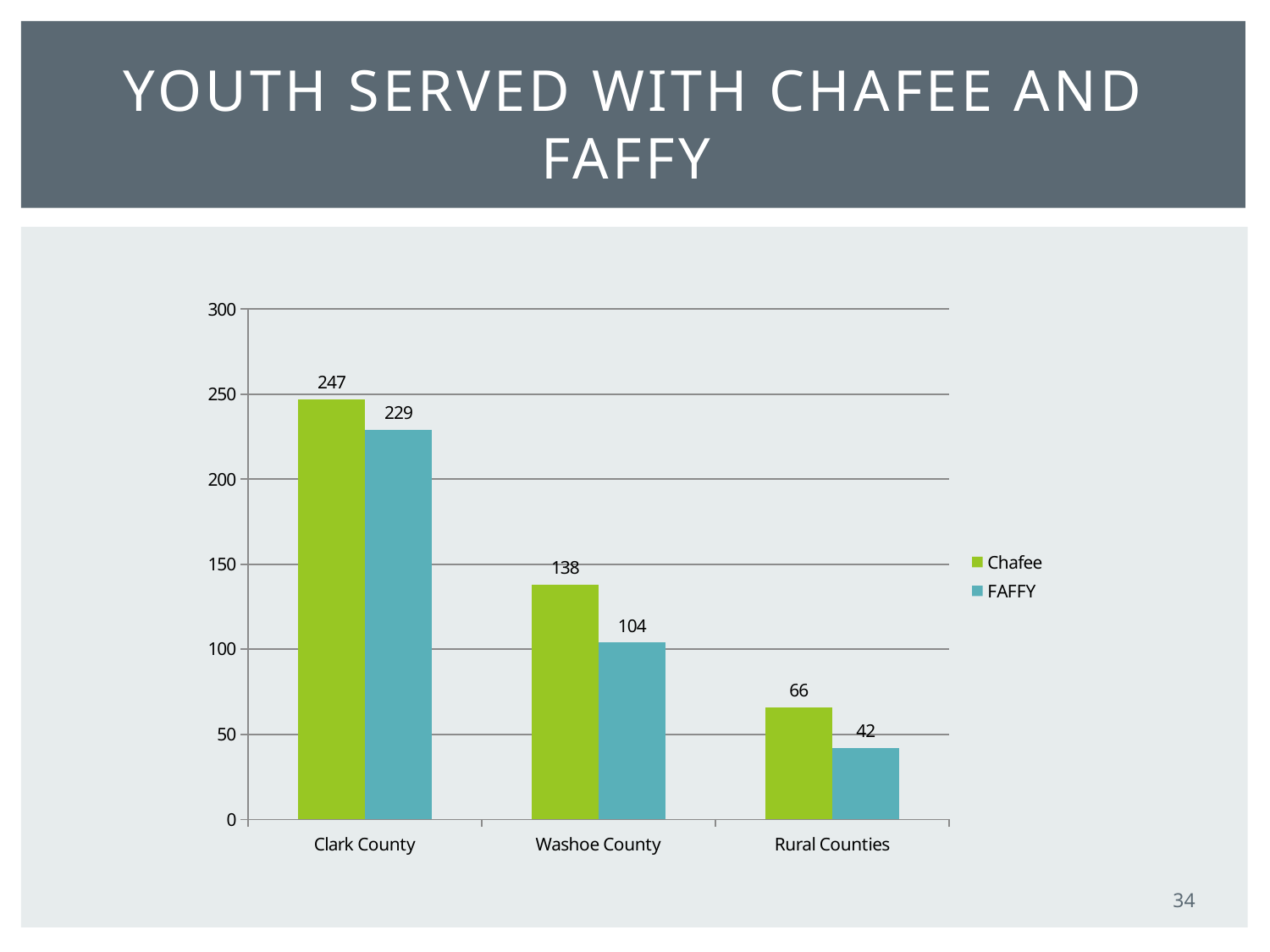
What is the FAFFY value for Rural Counties? 42 What kind of chart is shown on the slide? Bar chart Do the Chafee values rise or fall from Clark County to Rural Counties? Fall What is the Chafee value for Clark County? 247 What is the difference between the Chafee values for Clark County and Rural Counties? 181 How many series does the legend list? 2 Which category has the highest Chafee value? Clark County What is the FAFFY value for Washoe County? 104 Which category has the lowest FAFFY value? Rural Counties How many categories are shown on the x axis? 3 What is the difference between the Chafee and FAFFY values for Washoe County? 34 Which is larger for Rural Counties, the Chafee value or the FAFFY value? Chafee